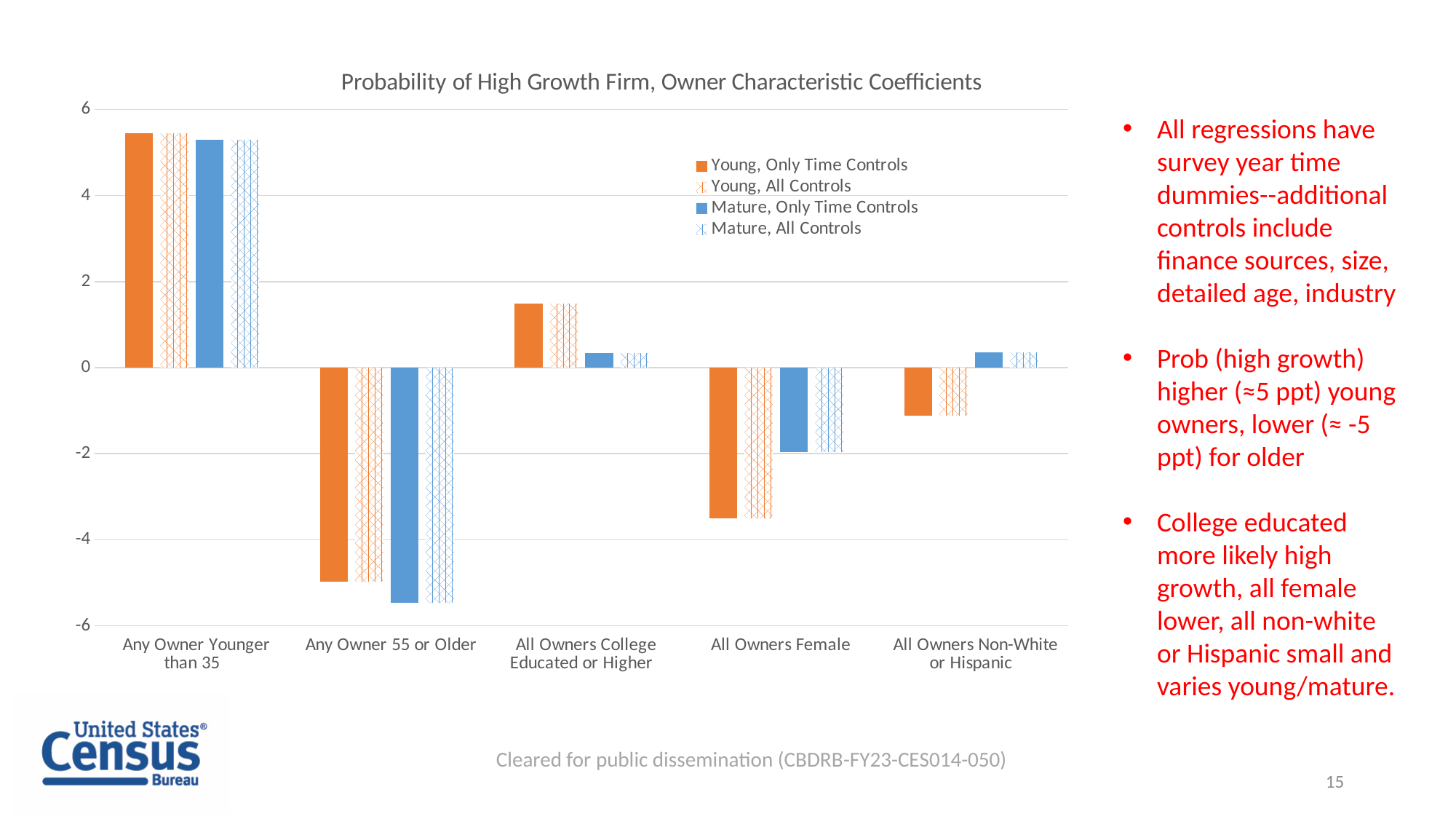
Is the 'Young, Only Time Controls' value for All Owners College Educated or Higher greater or less than 2? less How many series does the legend list? 4 Is the 'Mature, Only Time Controls' value for Any Owner 55 or Older greater or less than -4? less Is the 'Young, Only Time Controls' value for All Owners Female greater or less than -2? less For the 'Young, Only Time Controls' series, which category has the highest value? Any Owner Younger than 35 What kind of chart is shown on the slide? bar chart For All Owners Female, which series has the higher value: 'Young, Only Time Controls' or 'Mature, Only Time Controls'? Mature, Only Time Controls How many owner characteristic categories are shown on the x axis? 5 For All Owners College Educated or Higher, which series has the higher value: 'Young, Only Time Controls' or 'Mature, Only Time Controls'? Young, Only Time Controls For the 'Mature, Only Time Controls' series, which category has the lowest value? Any Owner 55 or Older What is the title of the chart? Probability of High Growth Firm, Owner Characteristic Coefficients